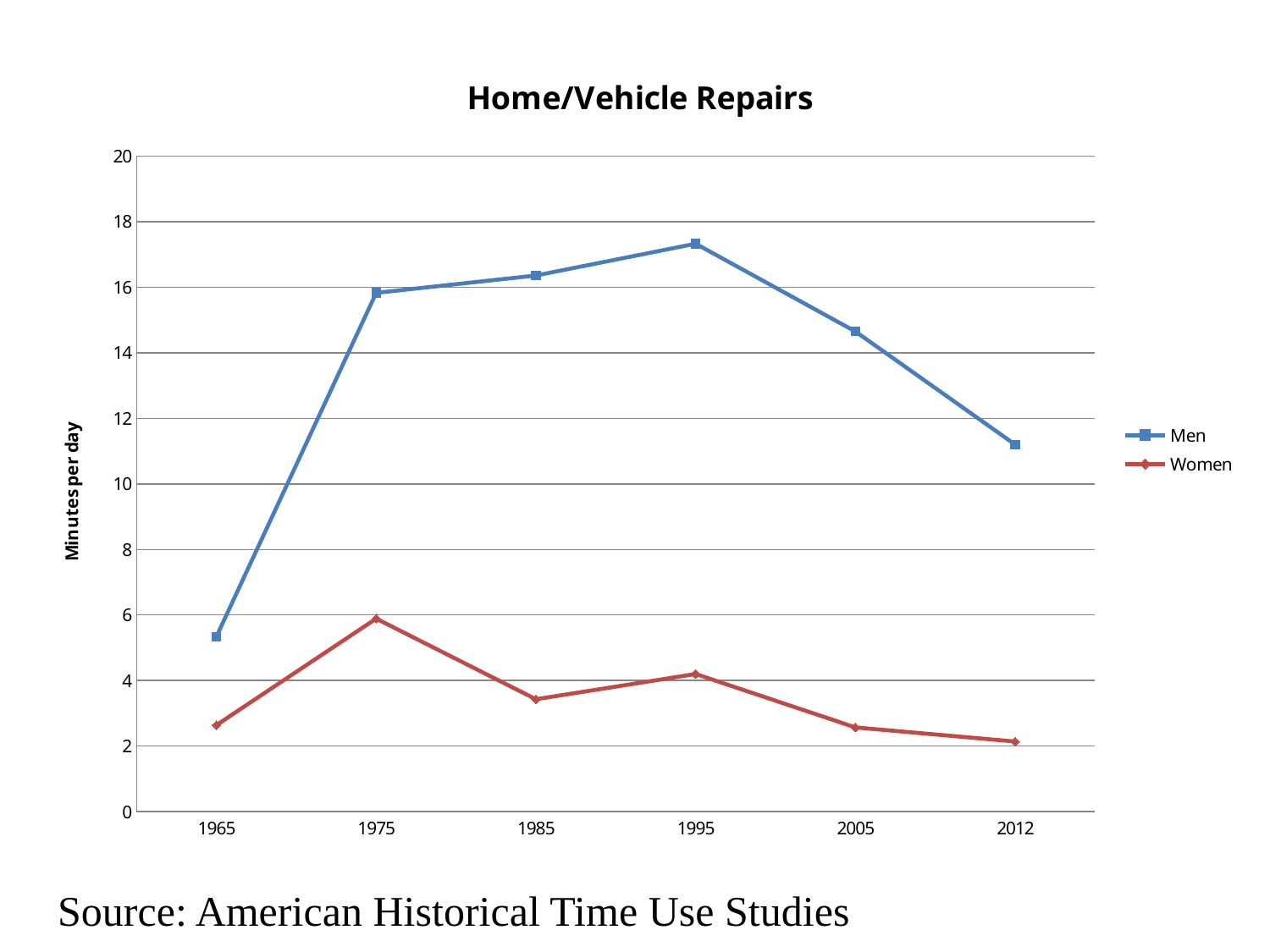
Which series has the larger value in 1985, Men or Women? Men Is the value for Men in 1995 greater or less than 16? greater How many series does the legend list? 2 In which year is the value for Men lowest? 1965 Is the value for Women in 1985 greater or less than 4? less Is the value for Men in 1965 greater or less than 6? less In which year is the value for Men highest? 1995 What is the title of the chart? Home/Vehicle Repairs Do the values for Men rise or fall from 1995 to 2012? fall What type of chart is shown on the slide? line chart In which year is the value for Women highest? 1975 How many years are plotted along the x axis? 6